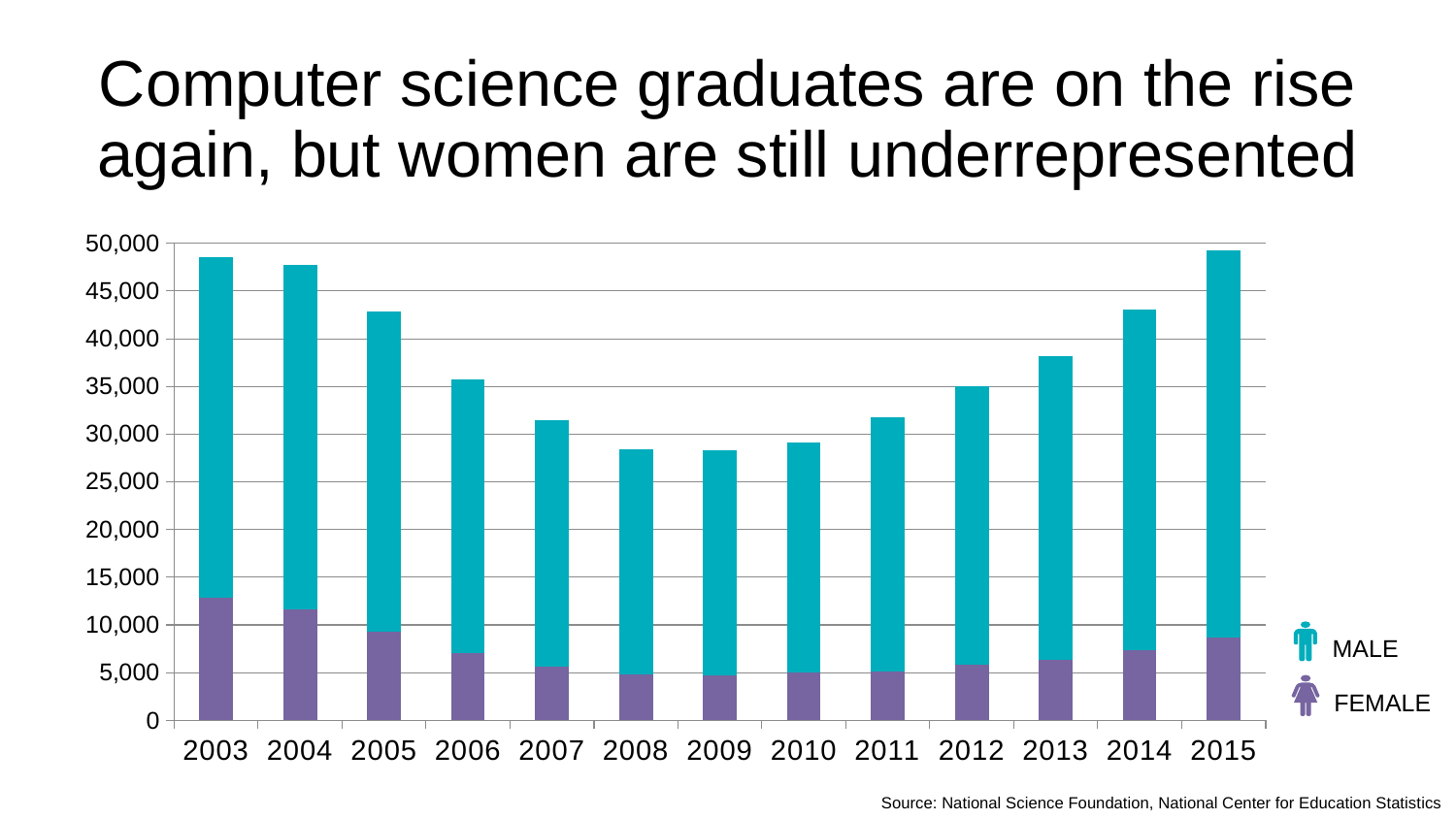
How many years are shown on the x axis of the chart? 13 Is the total number of graduates for 2014 greater or less than 40,000? greater How many series does the chart's legend list? 2 Which series does the purple colour represent in the chart? FEMALE Is the FEMALE value for 2003 greater or less than 10,000? greater Do the total bar heights rise or fall from 2009 to 2015? rise Is the total number of graduates for 2003 greater or less than 45,000? greater Which year has the highest FEMALE value? 2003 Which is larger, the total for 2003 or the total for 2010? 2003 What kind of chart is shown on the slide? Stacked bar chart Do the total bar heights rise or fall from 2003 to 2009? fall